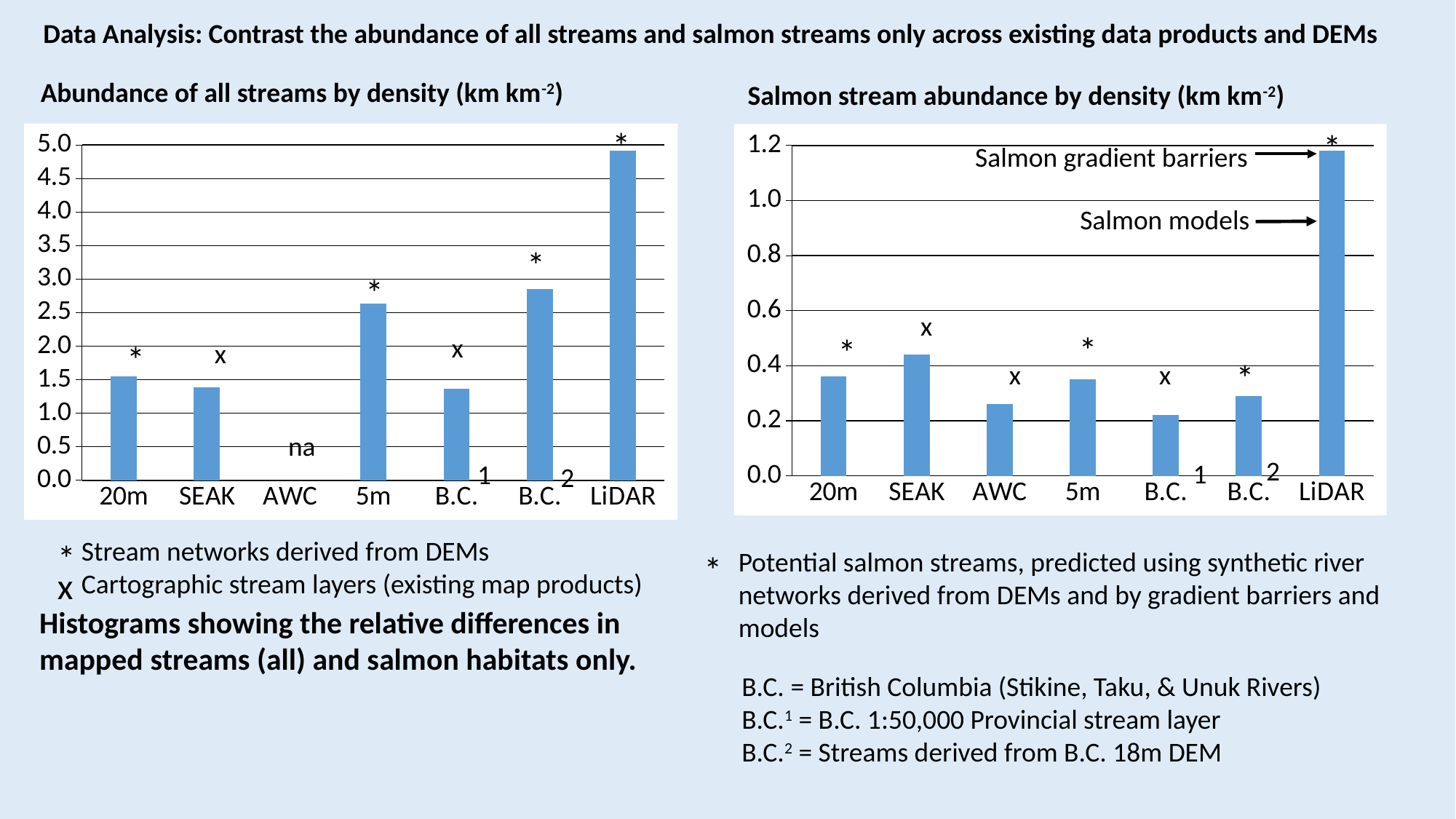
In the 'Abundance of all streams by density' chart, which is larger, the value for 5m or the value for B.C.2? B.C.2 In the 'Salmon stream abundance by density' chart, is the value for LiDAR greater or less than 1.0? greater What kind of chart is the 'Abundance of all streams by density' chart? Bar chart In the 'Salmon stream abundance by density' chart, which category has the highest value? LiDAR In the 'Abundance of all streams by density' chart, is the value for SEAK greater or less than 1.5? less In the 'Abundance of all streams by density' chart, which category has the highest value? LiDAR In the 'Abundance of all streams by density' chart, is the value for LiDAR greater or less than 4.5? greater In the 'Salmon stream abundance by density' chart, which category has the lowest value? B.C.1 In the 'Salmon stream abundance by density' chart, which is larger, the value for SEAK or the value for 20m? SEAK How many categories are shown on the x axis of the 'Salmon stream abundance by density' chart? 7